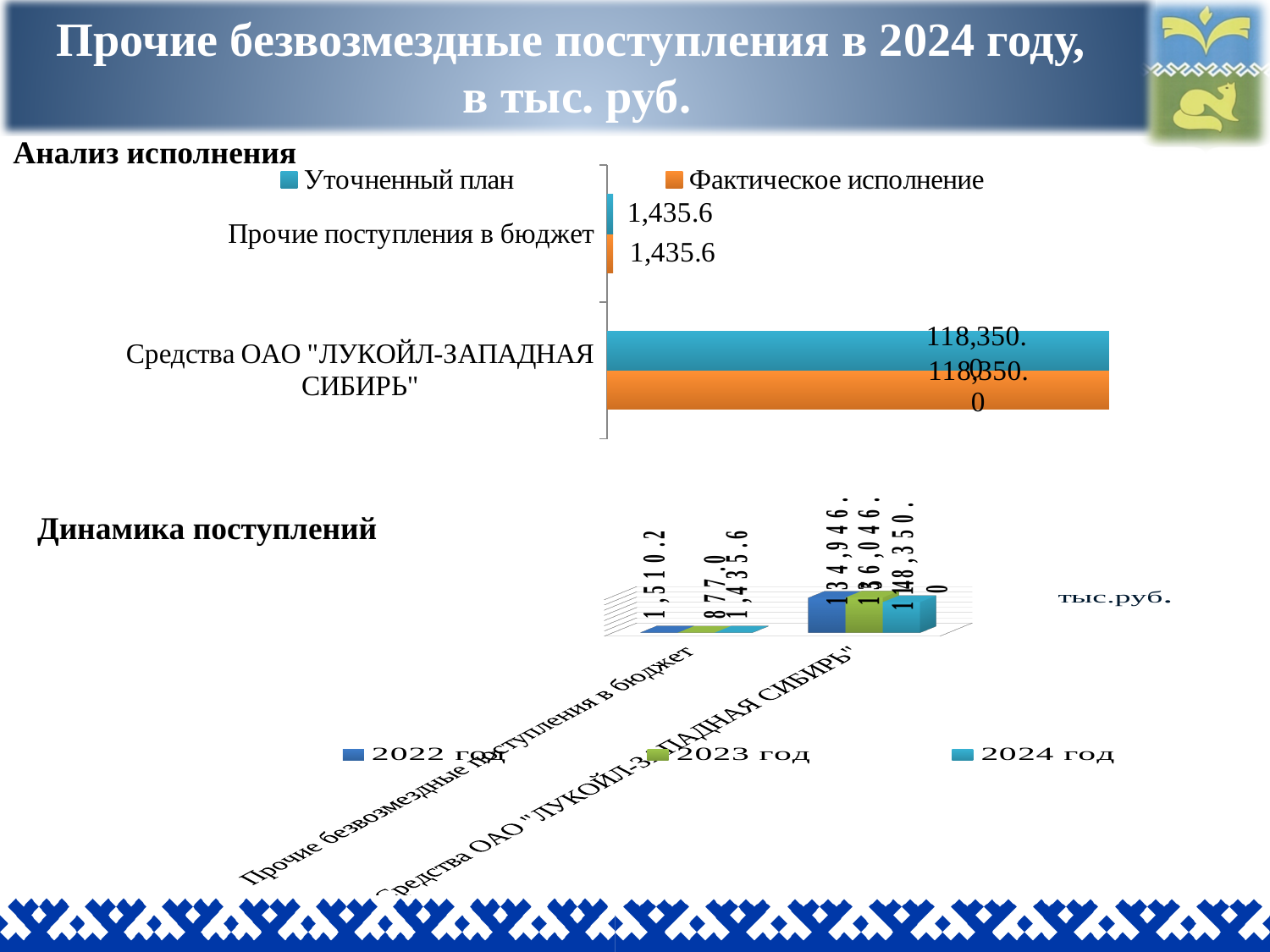
What kind of chart is the 'Анализ исполнения' chart? Bar chart In the 'Анализ исполнения' chart, which category has the higher 'Фактическое исполнение' value? Средства ОАО "ЛУКОЙЛ-ЗАПАДНАЯ СИБИРЬ" In the 'Динамика поступлений' chart, what is the 2022 год value for 'Прочие безвозмездные поступления в бюджет'? 1,510.2 In the 'Динамика поступлений' chart, which year has the lowest value for 'Средства ОАО "ЛУКОЙЛ-ЗАПАДНАЯ СИБИРЬ"'? 2024 год In the 'Динамика поступлений' chart, what is the 2023 год value for 'Прочие безвозмездные поступления в бюджет'? 877.0 In the 'Анализ исполнения' chart, how many categories are shown? 2 In the 'Анализ исполнения' chart, what is the 'Фактическое исполнение' value for 'Средства ОАО "ЛУКОЙЛ-ЗАПАДНАЯ СИБИРЬ"'? 118,350.0 In the 'Анализ исполнения' chart, how many series does the legend list? 2 In the 'Динамика поступлений' chart, which year has the lowest value for 'Прочие безвозмездные поступления в бюджет'? 2023 год In the 'Анализ исполнения' chart, what is the 'Уточненный план' value for 'Прочие поступления в бюджет'? 1,435.6 In the 'Анализ исполнения' chart, what is the difference between the 'Уточненный план' and 'Фактическое исполнение' values for 'Прочие поступления в бюджет'? 0 In the 'Динамика поступлений' chart, how many series does the legend list? 3